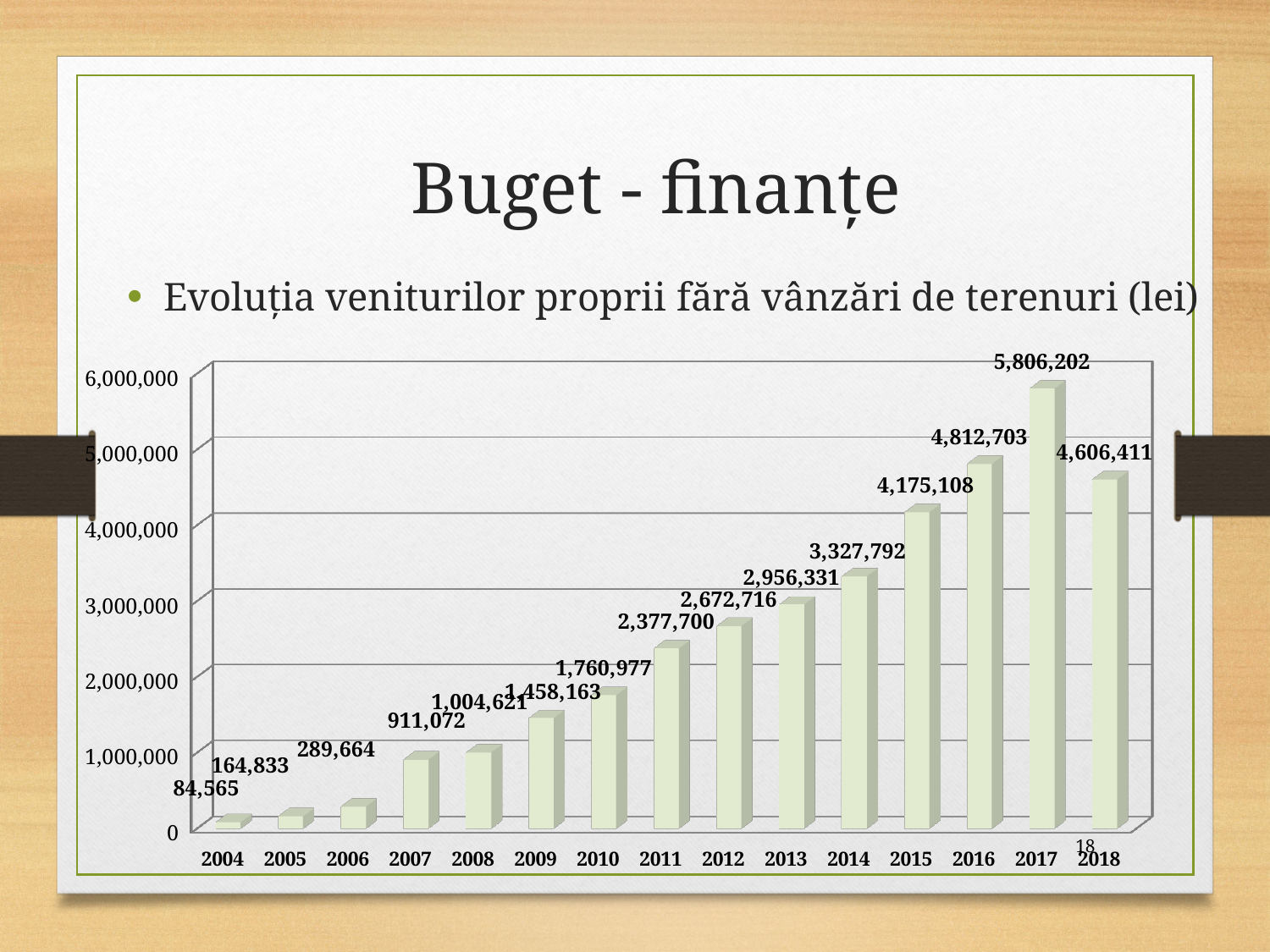
What is the value for 2012? 2,672,716 Which year has the highest value? 2017 Which year has the lowest value? 2004 Which is larger, the value for 2015 or the value for 2018? 2018 What is the value for 2004? 84,565 What is the difference between the values for 2017 and 2016? 993,499 What kind of chart is shown on the slide? bar chart What is the difference between the values for 2017 and 2018? 1,199,791 What is the value for 2018? 4,606,411 Is the value for 2014 greater or less than 3,000,000? greater What is the value for 2017? 5,806,202 How many years are shown on the x axis? 15